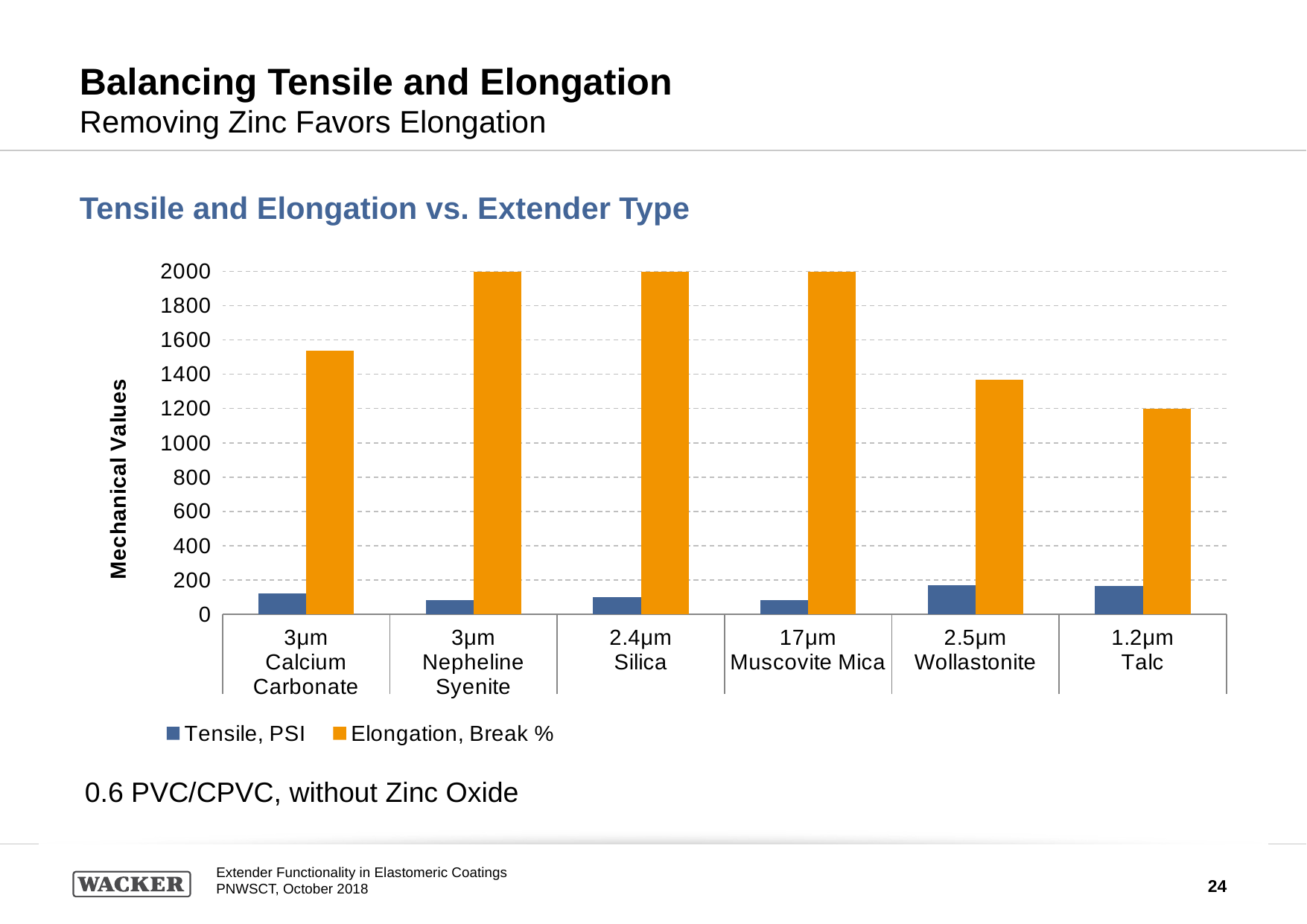
How many extender types are shown on the x axis of the chart? 6 What is the Elongation, Break % value for 17µm Muscovite Mica? 2000 How many series does the chart legend list? 2 What is the title of the chart? Tensile and Elongation vs. Extender Type Which has the larger Tensile, PSI value: 2.5µm Wollastonite or 3µm Nepheline Syenite? 2.5µm Wollastonite Which has the larger Elongation, Break % value: 3µm Calcium Carbonate or 2.5µm Wollastonite? 3µm Calcium Carbonate Is the Tensile, PSI value for 2.5µm Wollastonite greater or less than 200? less What kind of chart is shown on the slide? Bar chart Is the Elongation, Break % value for 3µm Calcium Carbonate greater or less than 1400? greater What is the Elongation, Break % value for 2.4µm Silica? 2000 Which extender type has the lowest Elongation, Break % value? 1.2µm Talc